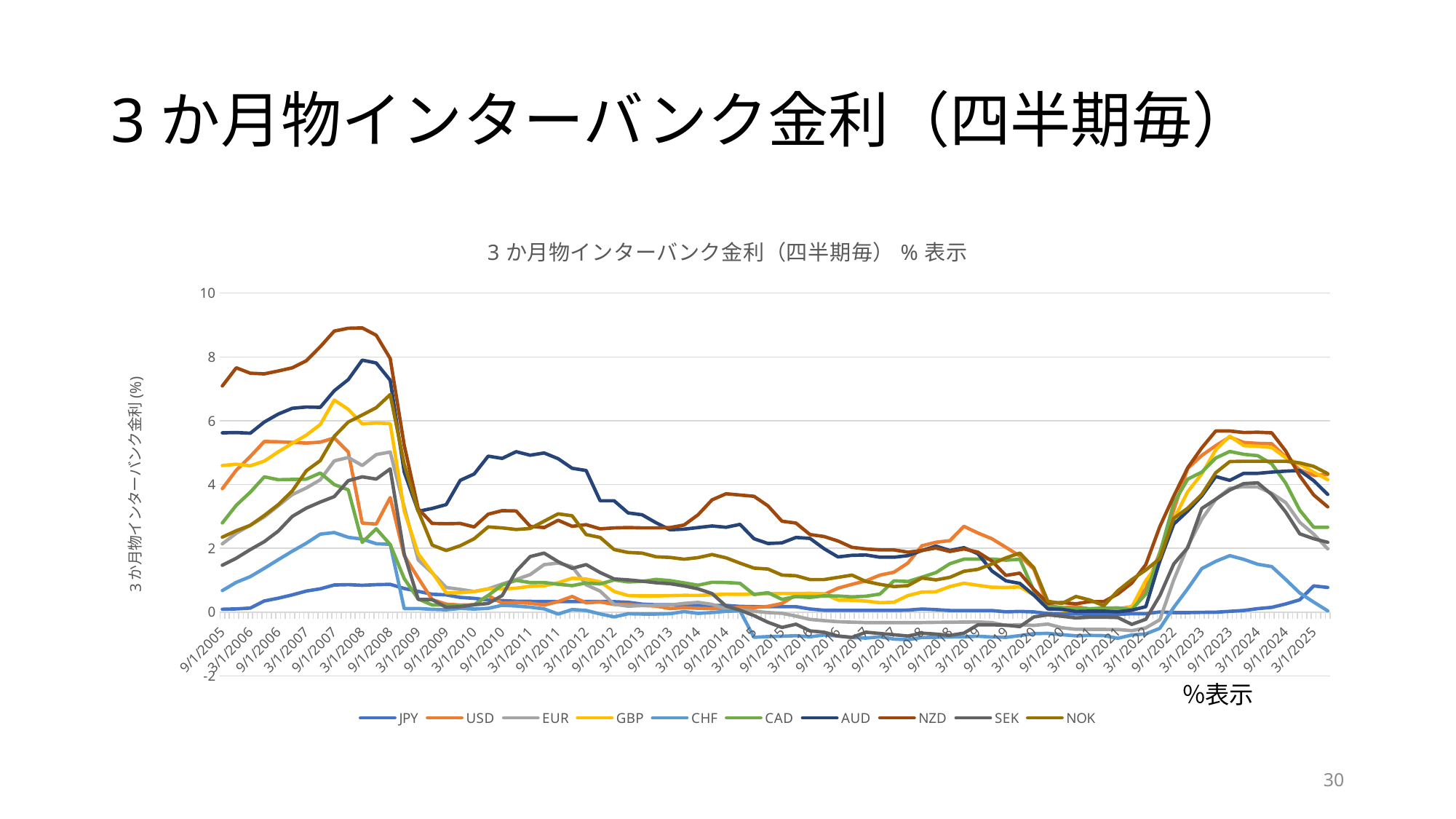
Which series has the highest value at 9/1/2005? NZD Is the value for JPY at 9/1/2023 greater or less than 2? less Is the value for AUD at 3/1/2011 greater or less than 4? greater What is the title of the chart? ３か月物インターバンク金利（四半期毎） % 表示 At 9/1/2023, which is larger, NZD or JPY? NZD Is the value for NZD at 3/1/2008 greater or less than 8? greater What is the label on the vertical axis of the chart? ３か月物インターバンク金利 (%) What kind of chart is shown on the slide? line chart Does the AUD series rise or fall between 3/1/2008 and 3/1/2009? fall How many series does the legend list? 10 Which series has the highest value at 3/1/2008? NZD